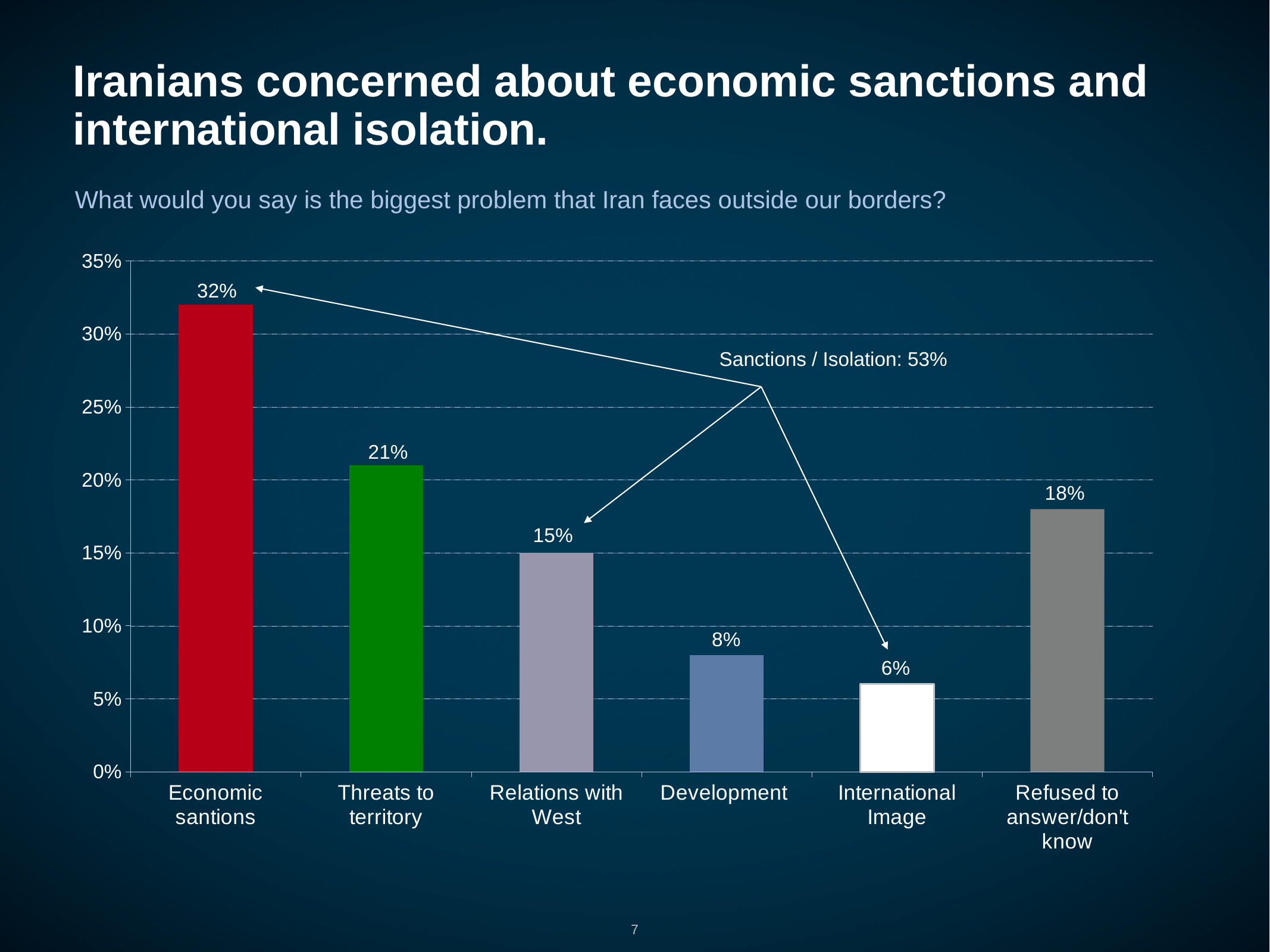
What is the value shown for International Image? 6% What is the value shown for Threats to territory? 21% What is the value shown for Refused to answer/don't know? 18% Which category has the highest value? Economic santions Which category has the lowest value? International Image What is the difference between the values for Economic santions and Threats to territory? 11% What percentage of respondents named Economic santions as the biggest problem Iran faces outside its borders? 32% What combined figure does the annotation on the chart give for Sanctions / Isolation? 53% Which is larger, the value for Relations with West or the value for Development? Relations with West What kind of chart is shown on the slide? Bar chart What colour is the bar for Threats to territory? Green How many categories are shown on the x axis? 6